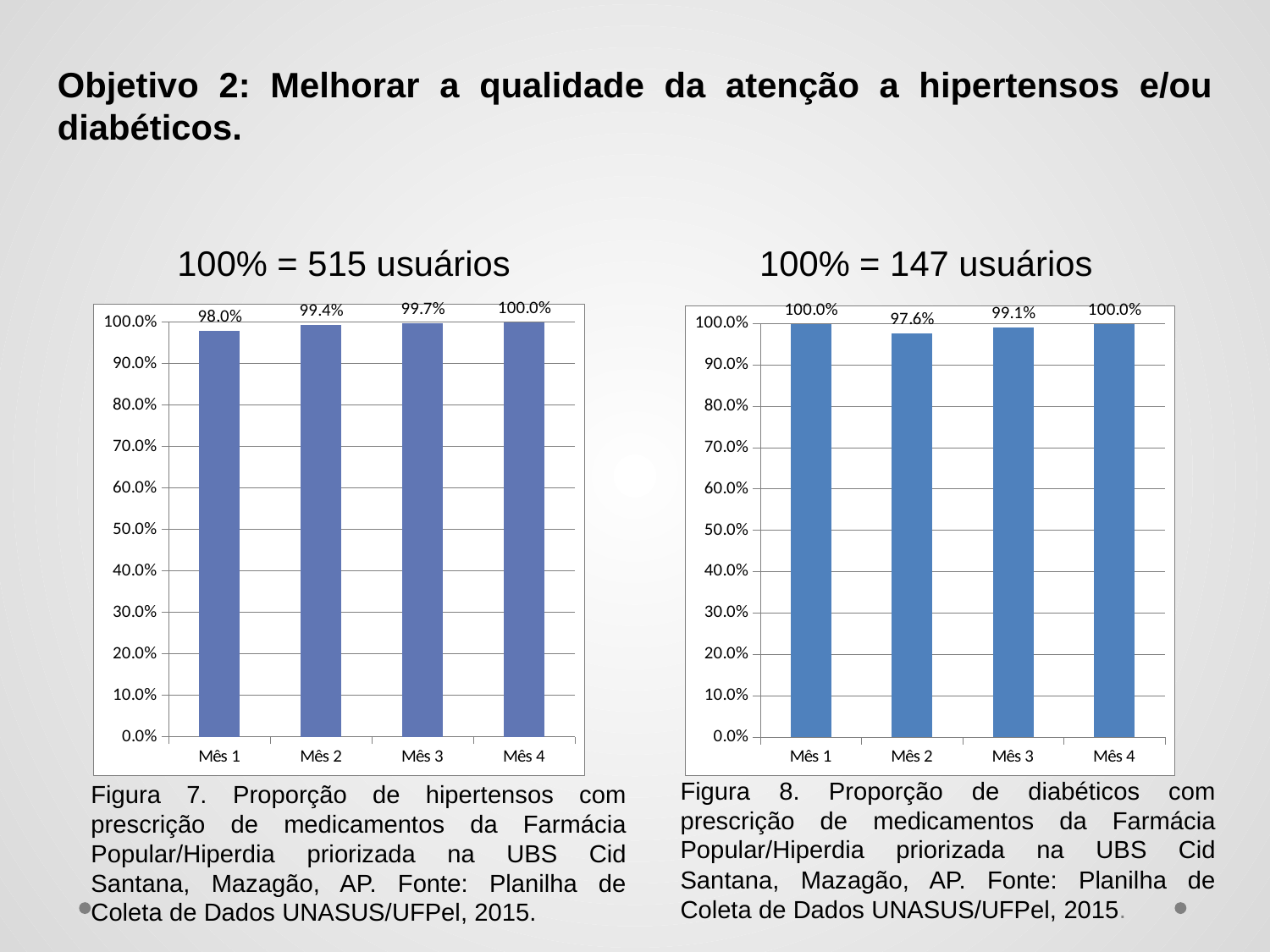
In the left chart (Figura 7, hipertensos), what is the value for Mês 1? 98.0% What kind of chart is the right chart (Figura 8, diabéticos)? Bar chart In the right chart (Figura 8, diabéticos), what is the value for Mês 3? 99.1% In the right chart (Figura 8, diabéticos), which is larger, the value for Mês 2 or the value for Mês 3? Mês 3 In the left chart (Figura 7, hipertensos), which month has the lowest value? Mês 1 In the left chart (Figura 7, hipertensos), what is the difference between the values for Mês 4 and Mês 1? 2.0% In the right chart (Figura 8, diabéticos), what is the difference between the values for Mês 1 and Mês 2? 2.4% In the left chart (Figura 7, hipertensos), what is the value for Mês 3? 99.7% In the right chart (Figura 8, diabéticos), what is the value for Mês 2? 97.6% How many months (categories) are shown in the left chart (Figura 7, hipertensos)? 4 In the right chart (Figura 8, diabéticos), which month has the lowest value? Mês 2 In the left chart (Figura 7, hipertensos), which month has the highest value? Mês 4